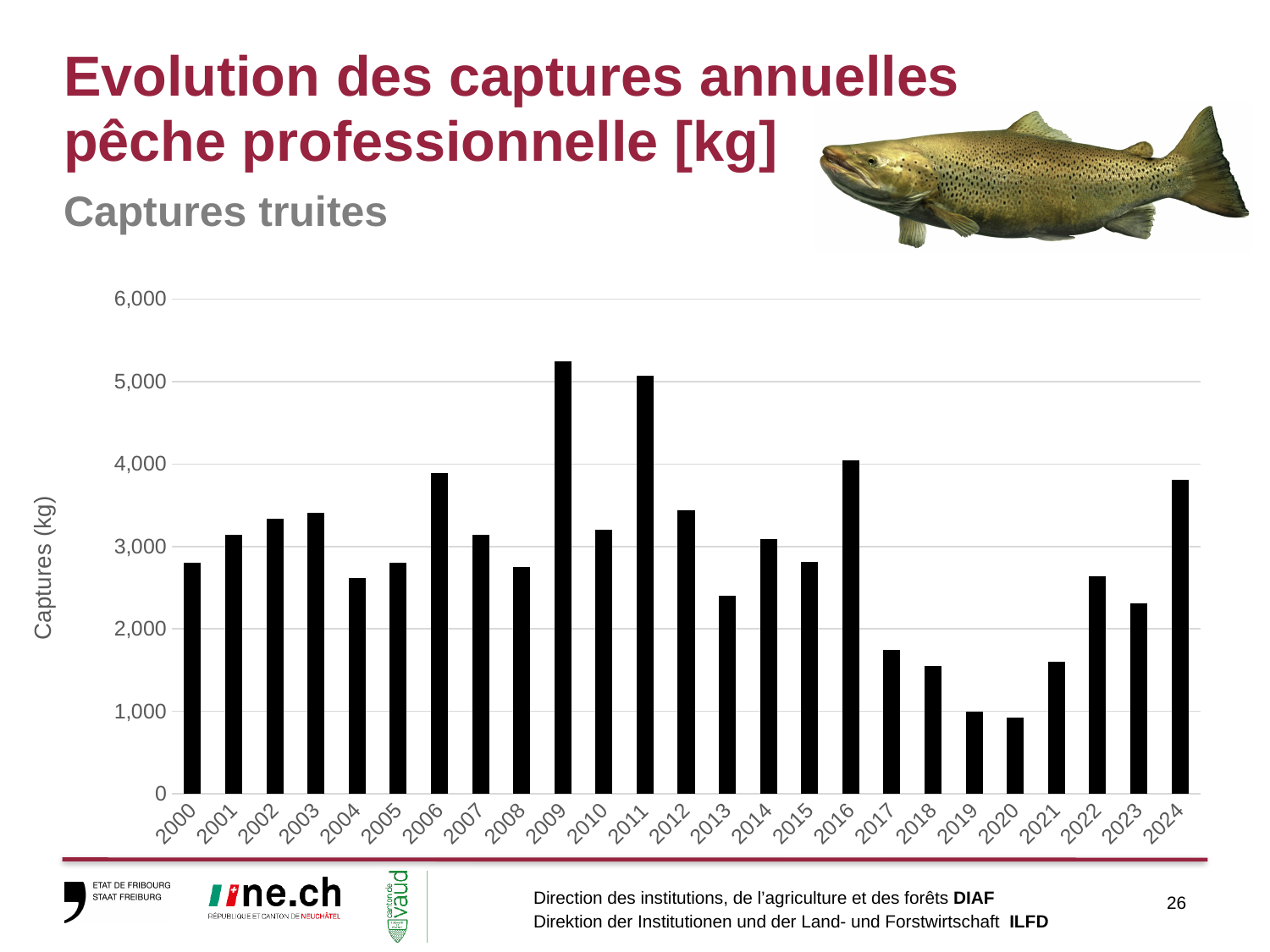
What kind of chart is shown on the slide? bar chart Is the value for 2009 greater or less than 5,000? greater How many years (bars) are plotted in the chart? 25 Which year has the larger catch, 2009 or 2011? 2009 Is the value for 2024 greater or less than 4,000? less Is the value for 2020 greater or less than 1,000? less Which year has the larger catch, 2006 or 2012? 2006 What is the label on the vertical axis of the chart? Captures (kg) Which year has the highest trout catch in the chart? 2009 Do the catches rise or fall from 2016 to 2020? fall